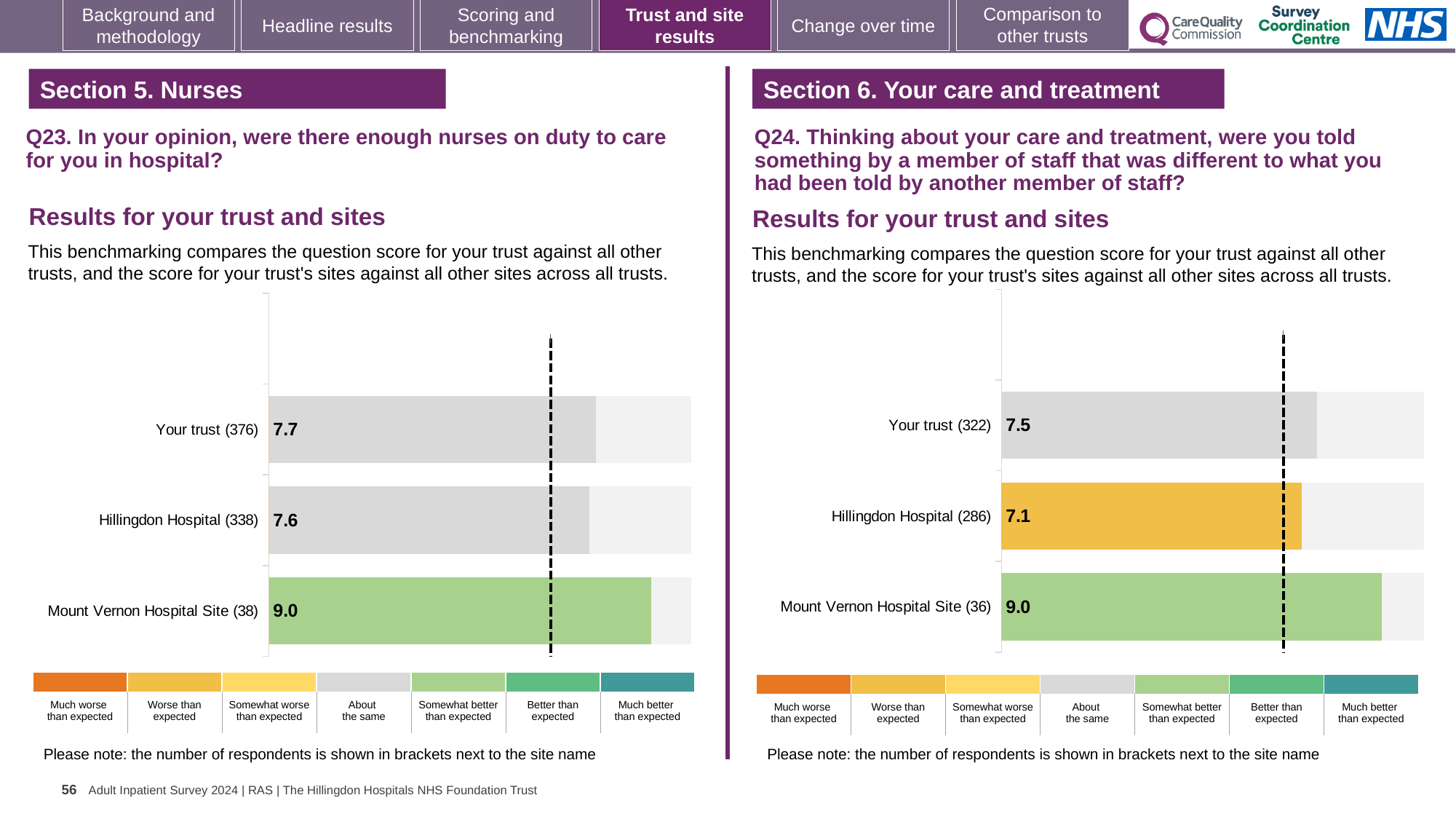
In the Q24 chart (right), what is the difference between the scores for Mount Vernon Hospital Site and Hillingdon Hospital? 1.9 What type of chart is used for the Q24 results (right)? Bar chart In the Q24 chart (right), what is the score for Hillingdon Hospital? 7.1 In the Q24 chart (right), which site or trust has the lowest score? Hillingdon Hospital In the Q24 chart (right), how many respondents are shown in brackets for Hillingdon Hospital? 286 In the Q23 chart (left), what is the score for Mount Vernon Hospital Site? 9.0 In the Q23 chart (left), what is the difference between the scores for Your trust and Hillingdon Hospital? 0.1 In the Q23 chart (left), which site or trust has the highest score? Mount Vernon Hospital Site In the Q23 chart (left), what is the score for Your trust? 7.7 In the Q24 chart (right), which has the larger score, Your trust or Hillingdon Hospital? Your trust How many bars are shown in the Q23 chart (left)? 3 In the Q24 chart (right), what is the score for Your trust? 7.5